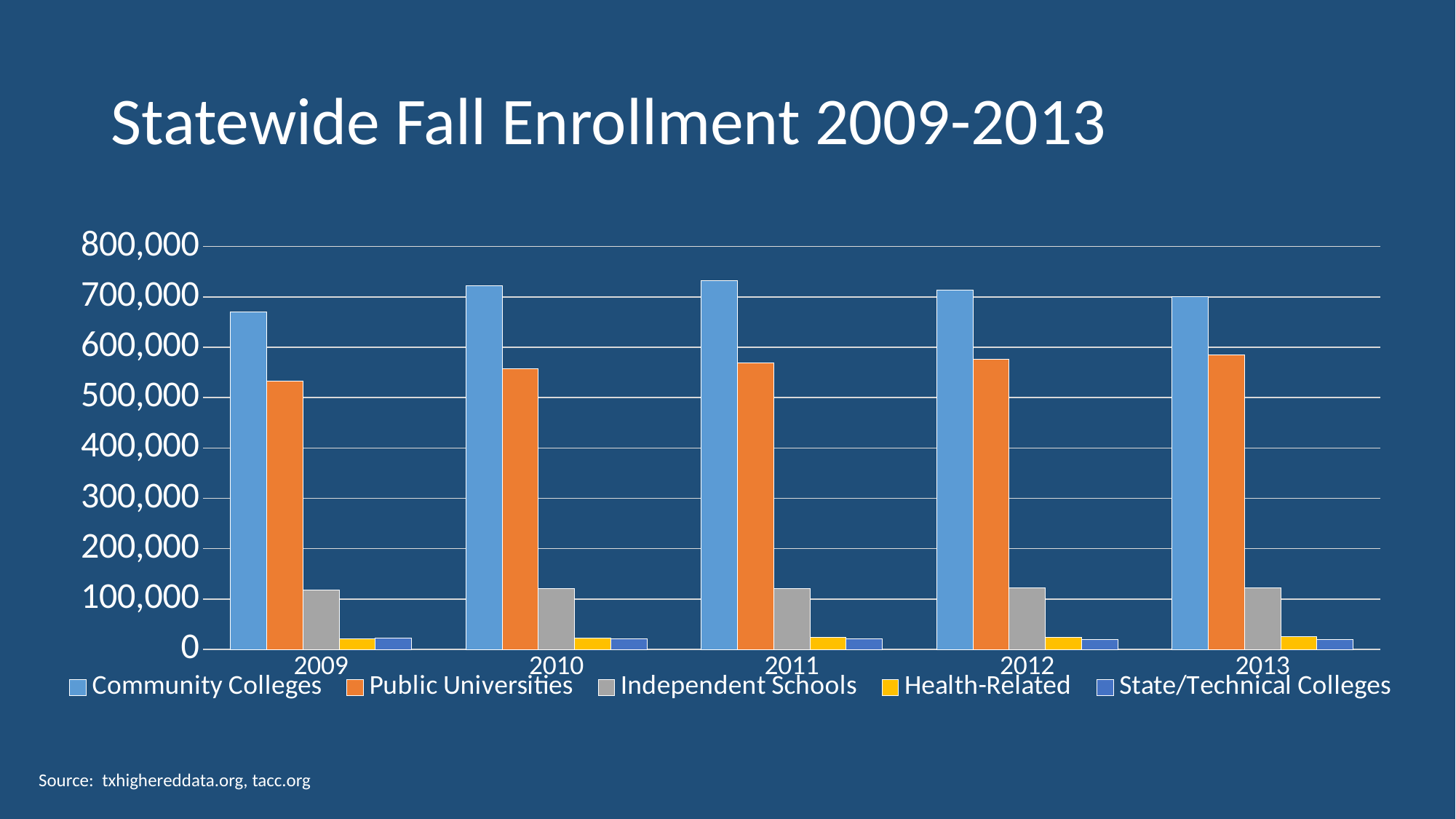
In which year is Community Colleges enrollment lowest? 2009 What is the title of the chart? Statewide Fall Enrollment 2009-2013 In which year is Community Colleges enrollment highest? 2011 In 2013, which is larger: Community Colleges or Public Universities? Community Colleges How many series does the legend list? 5 Is the value for Community Colleges in 2009 greater or less than 700,000? less Is the value for Independent Schools in 2012 greater or less than 100,000? greater Is the value for Community Colleges in 2011 greater or less than 700,000? greater How many years are shown on the x axis? 5 Do the Public Universities values rise or fall from 2009 to 2013? rise What kind of chart is shown on the slide? bar chart